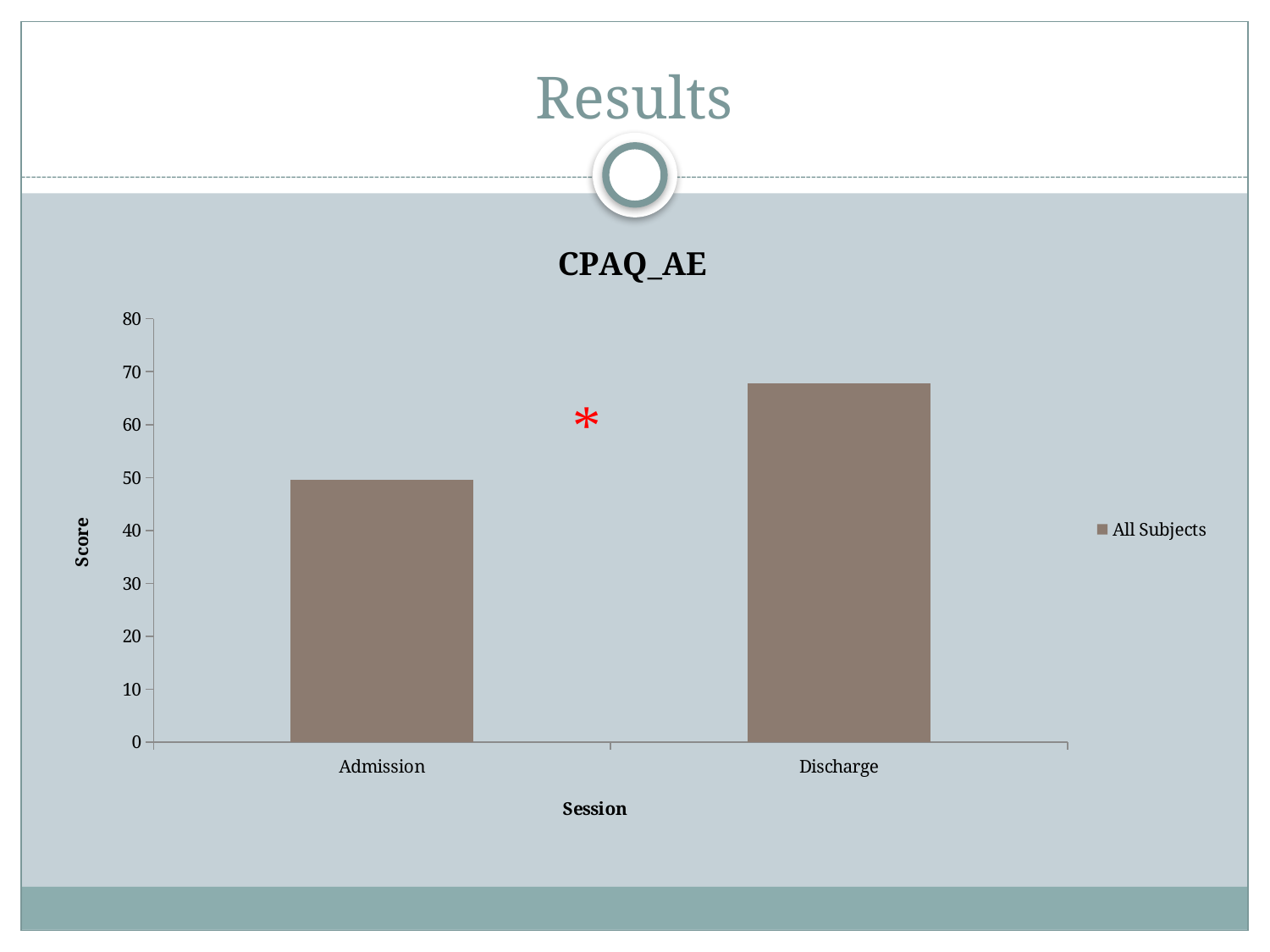
Which is larger, the score at Admission or at Discharge? Discharge Do the scores rise or fall from Admission to Discharge? rise Is the value for Admission greater or less than 60? less What is the title of the chart? CPAQ_AE Which session has the lowest score? Admission How many categories are shown on the x axis? 2 Which session has the highest score? Discharge What type of chart is shown on the slide? bar chart Is the value for Discharge greater or less than 60? greater Is the value for Discharge greater or less than 70? less What series name appears in the legend? All Subjects How many series does the legend list? 1